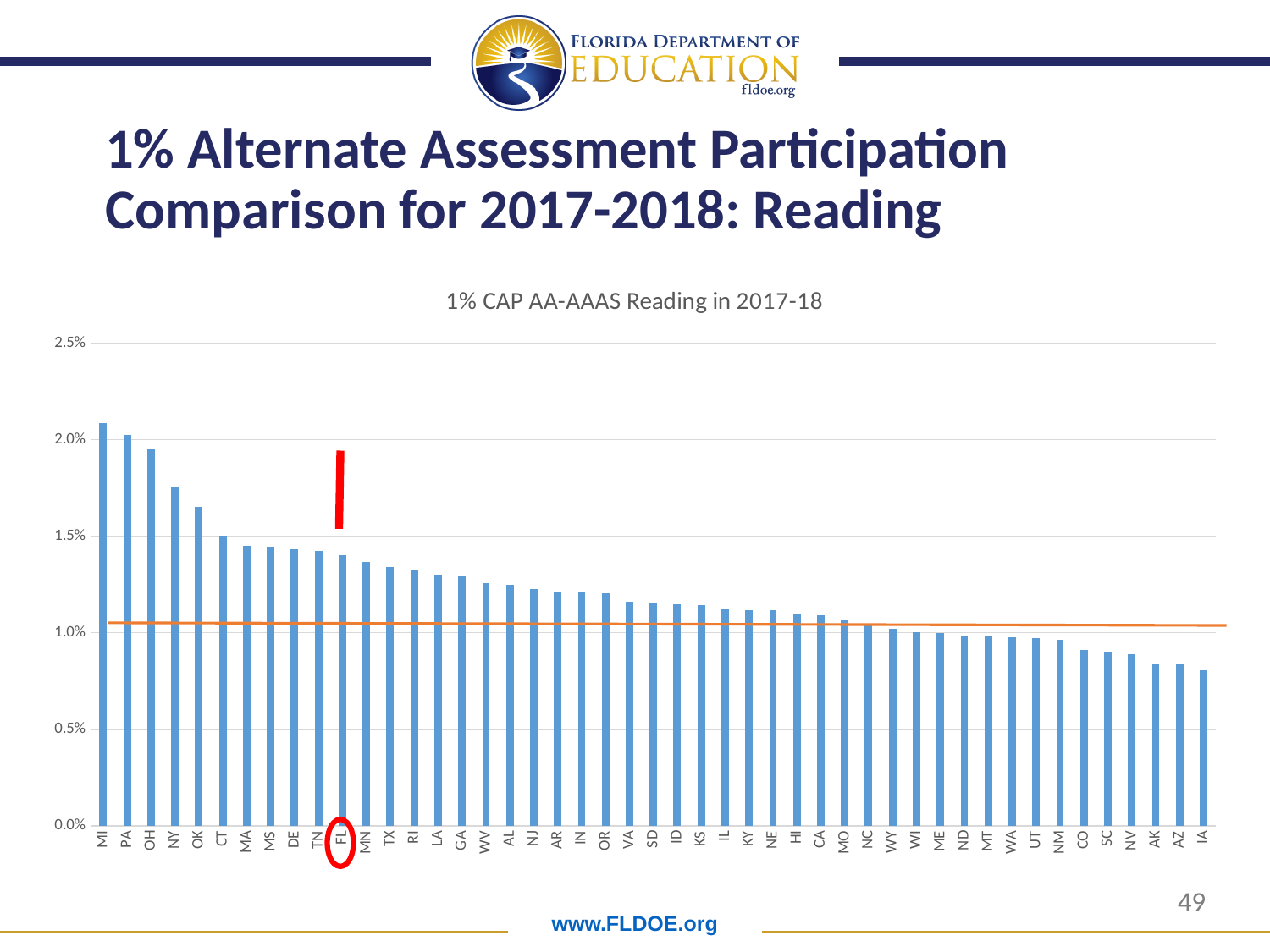
Is the value for NY greater or less than 1.5%? greater Is the value for FL greater or less than 1.5%? less What kind of chart is shown on the slide? bar chart Is the value for FL greater or less than 1.0%? greater Which has a larger value, NY or FL? NY Do the values rise or fall moving from left to right along the x axis? fall Which state's label is circled in red on the x axis? FL What is the title of the chart? 1% CAP AA-AAAS Reading in 2017-18 Which has a larger value, IA or MI? MI Which state has the highest value in the chart? MI